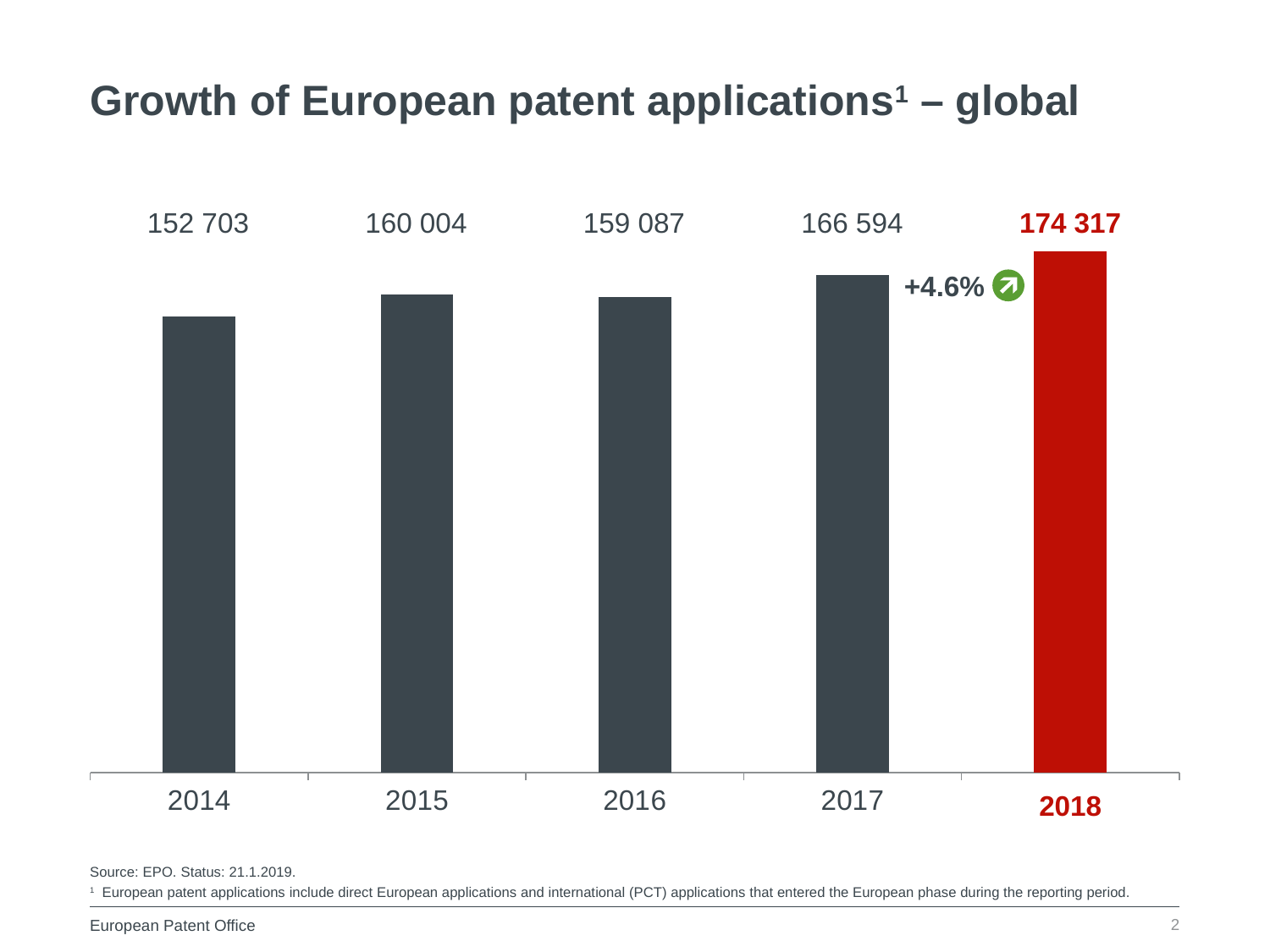
What is the value for 2014? 152 703 How many years are shown on the x axis? 5 Which bar is coloured red? 2018 Which is larger, the value for 2015 or the value for 2016? 2015 What percentage growth is annotated between 2017 and 2018? +4.6% What is the difference between the values for 2018 and 2017? 7 723 What is the value for 2016? 159 087 What is the value for 2018? 174 317 What kind of chart is this? Bar chart Which year has the lowest value? 2014 What is the difference between the values for 2015 and 2016? 917 Which year has the highest value? 2018